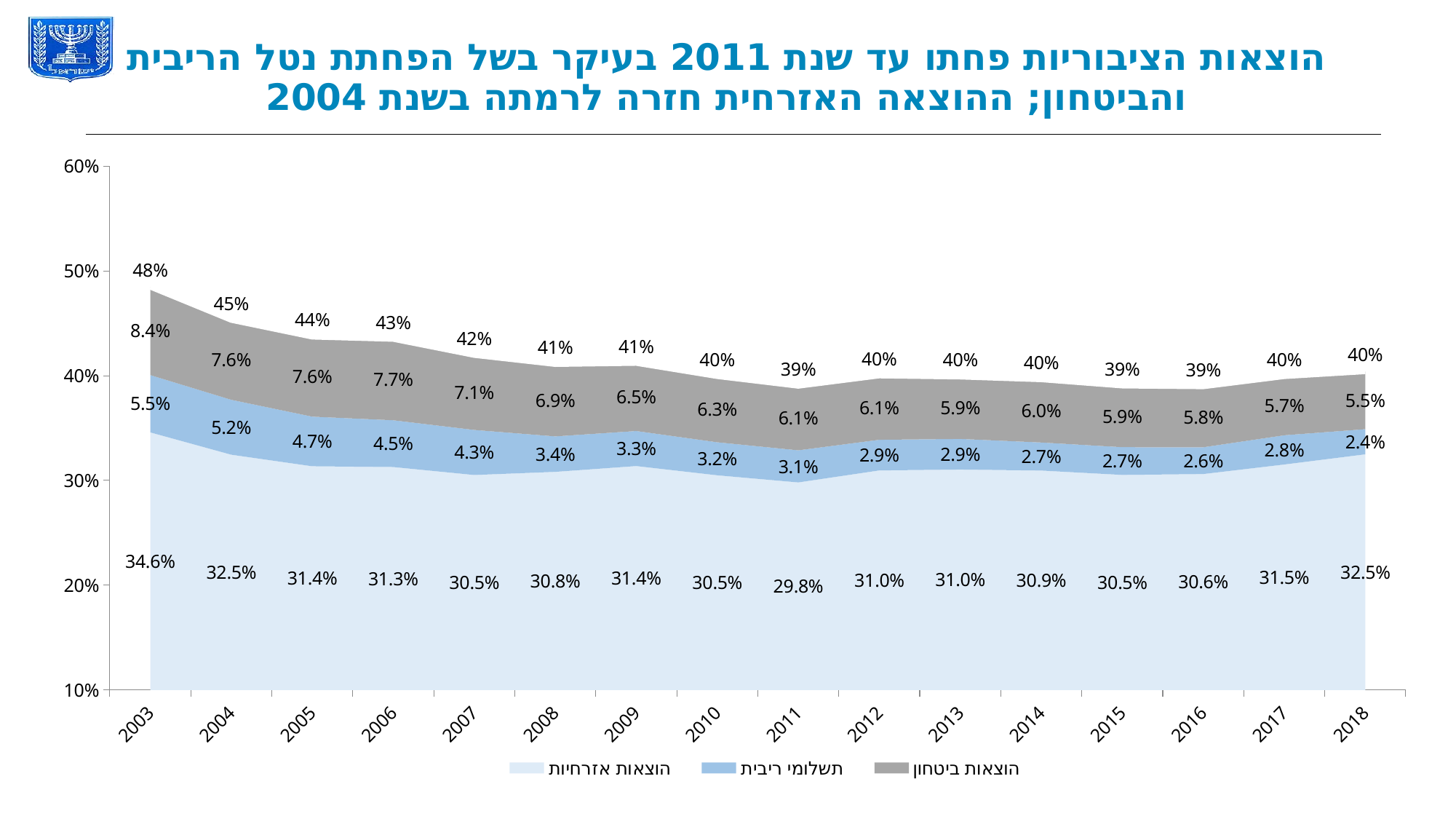
What is the value of הוצאות אזרחיות (civilian expenditure) in 2018? 32.5% What is the total labeled above the stack for 2003? 48% What is the value of הוצאות ביטחון (defense expenditure) in 2011? 6.1% In which year is הוצאות ביטחון (defense expenditure) highest? 2003 What is the value of תשלומי ריבית (interest payments) in 2003? 5.5% How many series does the legend list? 3 In which year is הוצאות אזרחיות (civilian expenditure) lowest? 2011 How many years are shown on the x axis? 16 Does the תשלומי ריבית (interest payments) series generally rise or fall from 2003 to 2018? Fall What kind of chart is shown on the slide? Stacked area chart Which is larger: הוצאות ביטחון (defense expenditure) in 2004 or in 2014? 2004 What is the difference between the תשלומי ריבית (interest payments) value in 2003 and in 2018? 3.1%